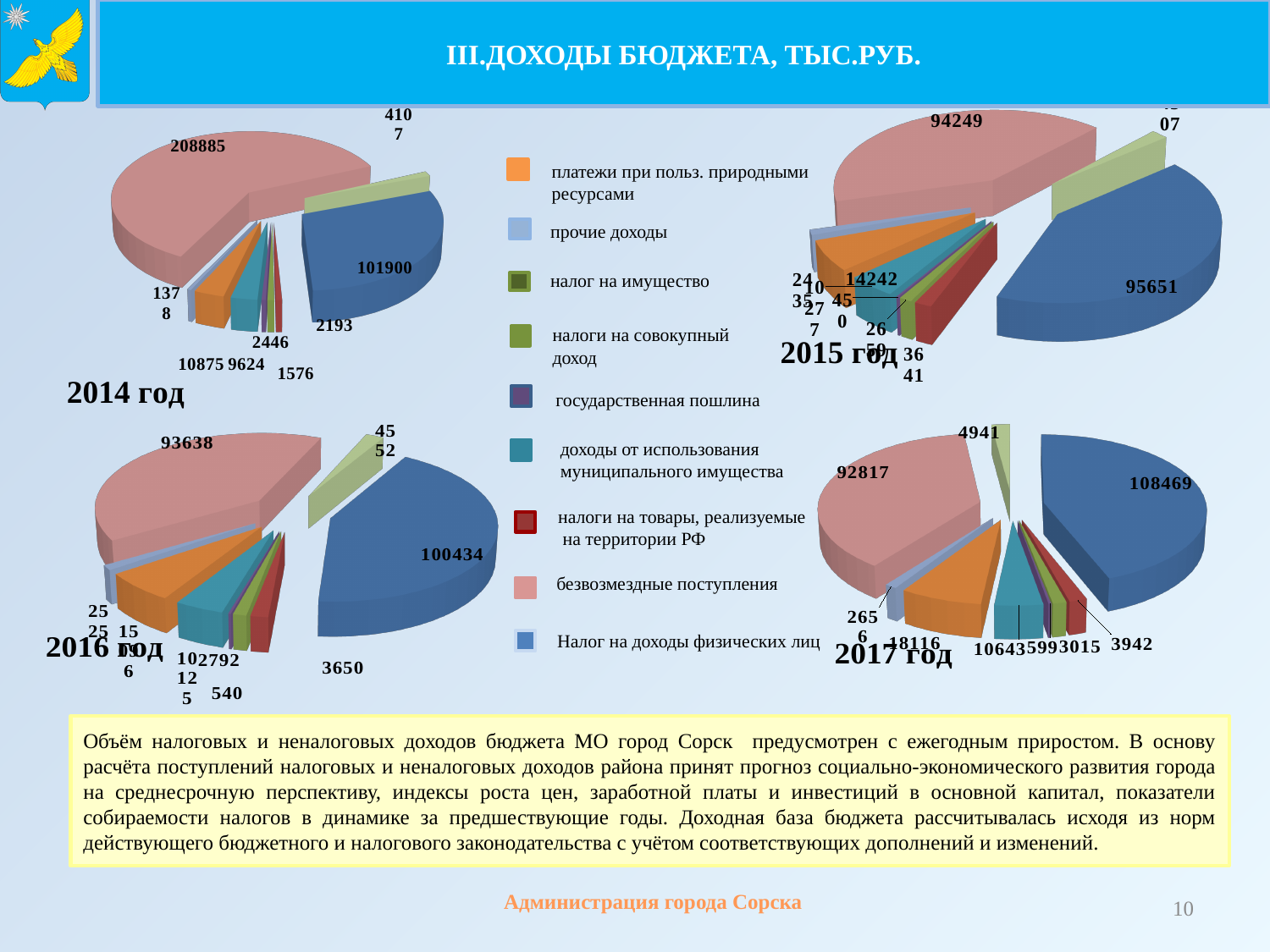
On the 2014 год chart, what is the difference between безвозмездные поступления and Налог на доходы физических лиц? 106985 On the 2015 год chart, which is larger: Налог на доходы физических лиц (95651) or безвозмездные поступления (94249)? Налог на доходы физических лиц On the 2017 год chart, what is the value for безвозмездные поступления? 92817 On the 2017 год chart, what is the difference between Налог на доходы физических лиц and безвозмездные поступления? 15652 On the 2016 год chart, what is the value for Налог на доходы физических лиц? 100434 On the 2014 год chart, what is the value for безвозмездные поступления? 208885 How many categories does the shared legend list? 9 What kind of chart is used for each year on this slide? pie chart On the 2014 год chart, what is the value for Налог на доходы физических лиц? 101900 On the 2014 год chart, which category has the largest slice? безвозмездные поступления On the 2017 год chart, which category has the largest slice? Налог на доходы физических лиц On the 2017 год chart, what is the value for Налог на доходы физических лиц? 108469